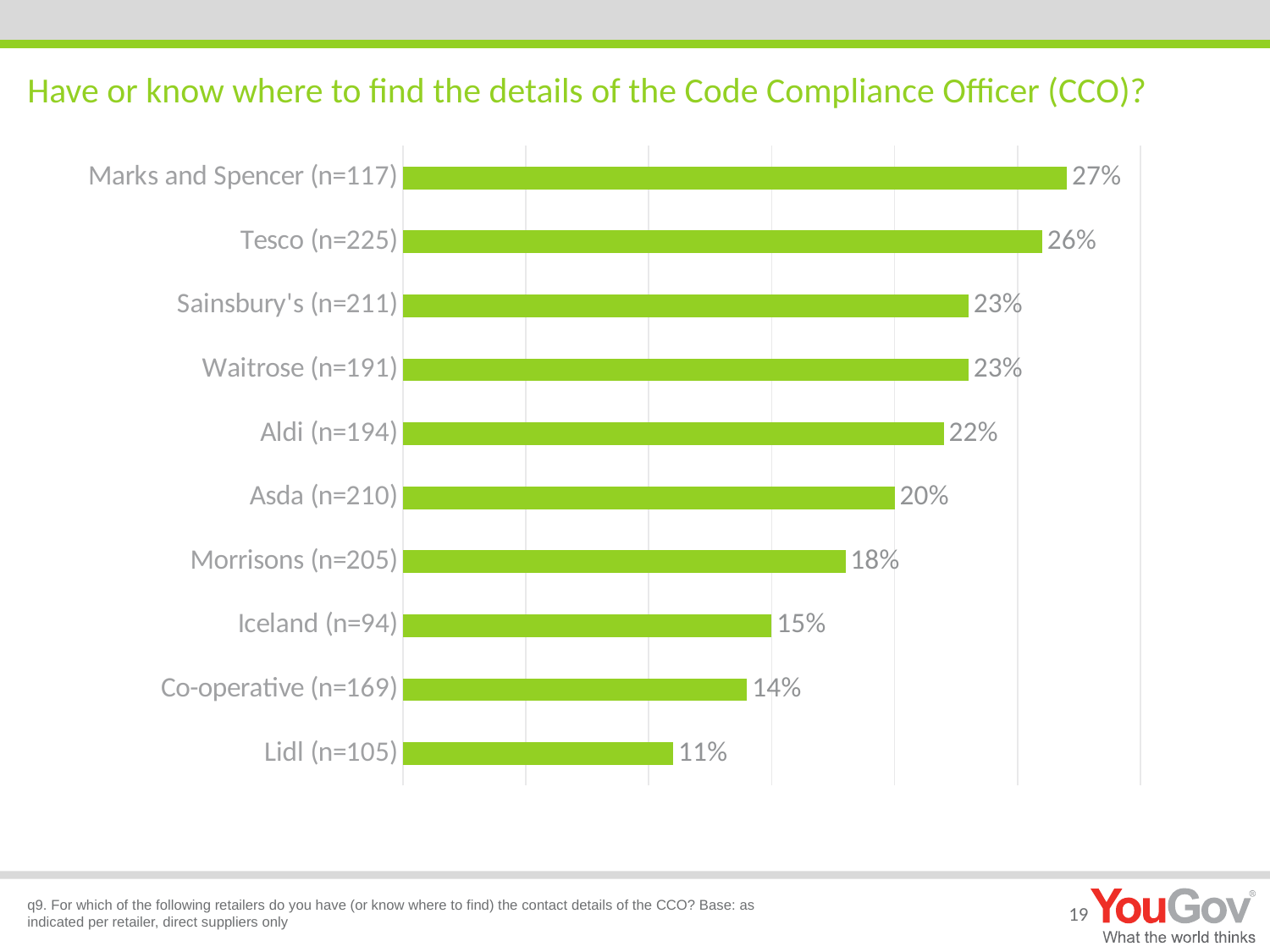
What is the value for Asda (n=210)? 20% What is the value for Tesco (n=225)? 26% What kind of chart is shown on the slide? Bar chart What is the difference between the values for Aldi (n=194) and Morrisons (n=205)? 4% What is the difference between the values for Marks and Spencer (n=117) and Lidl (n=105)? 16% What is the title of the chart? Have or know where to find the details of the Code Compliance Officer (CCO)? What is the value for Co-operative (n=169)? 14% How many retailers are shown in the chart? 10 Do the values rise or fall going from the top bar to the bottom bar? Fall Which is larger, the value for Iceland (n=94) or the value for Asda (n=210)? Asda (n=210) Which retailer has the lowest value? Lidl (n=105) Which retailer has the highest value? Marks and Spencer (n=117)